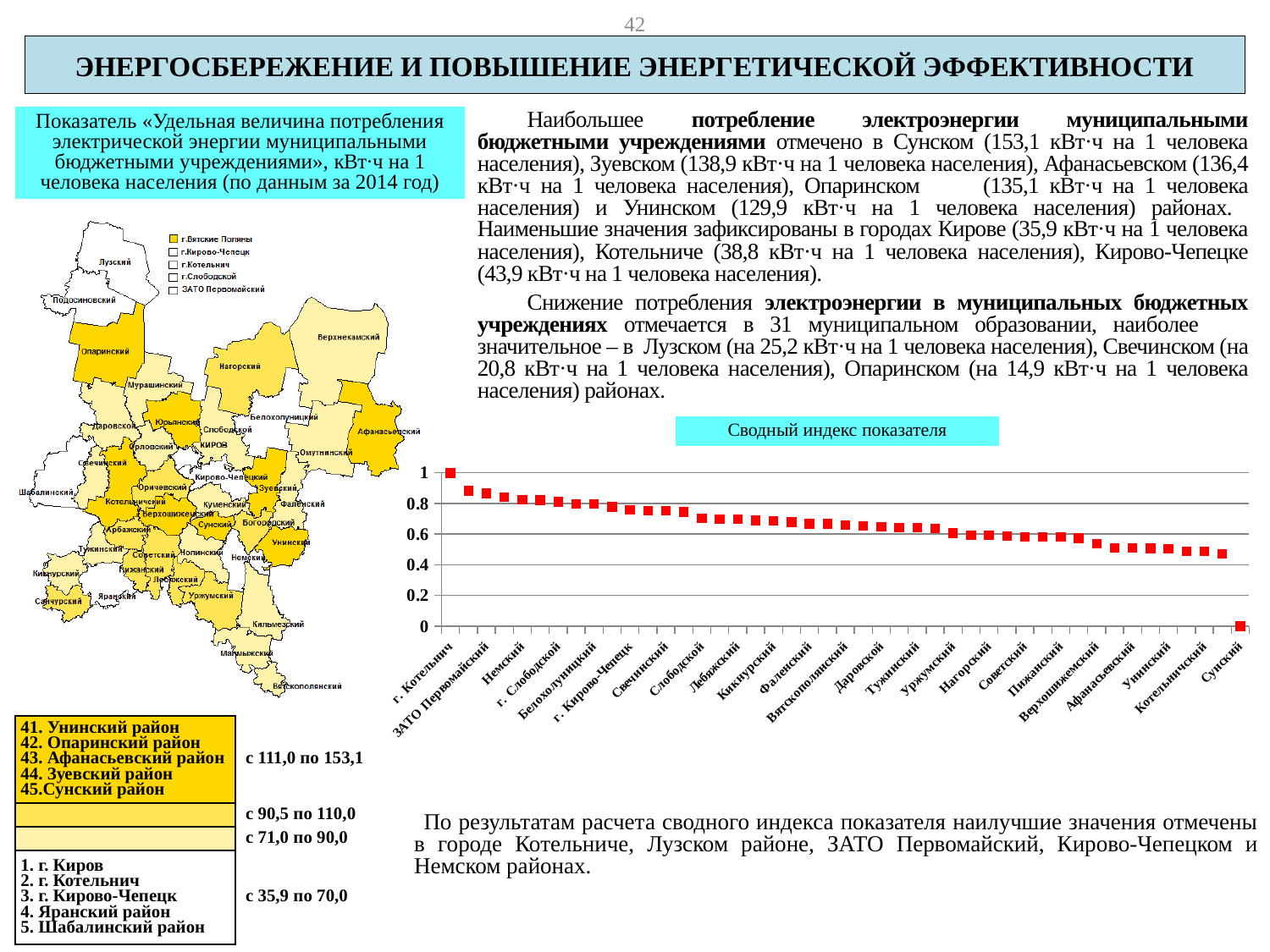
In the «Сводный индекс показателя» chart, is the value for г. Котельнич greater or less than 0.8? greater Which category has the lowest value in the «Сводный индекс показателя» chart? Сунский In the «Сводный индекс показателя» chart, is the value for Свечинский greater or less than 0.6? greater In the «Сводный индекс показателя» chart, is the value for Унинский greater or less than 0.6? less Which category has the highest value in the «Сводный индекс показателя» chart? г. Котельнич Do the values in the «Сводный индекс показателя» chart rise or fall from left to right along the x axis? fall What colour are the data markers in the «Сводный индекс показателя» chart? red What is the title of the chart on the slide? Сводный индекс показателя What kind of chart is shown under the title «Сводный индекс показателя»? scatter chart